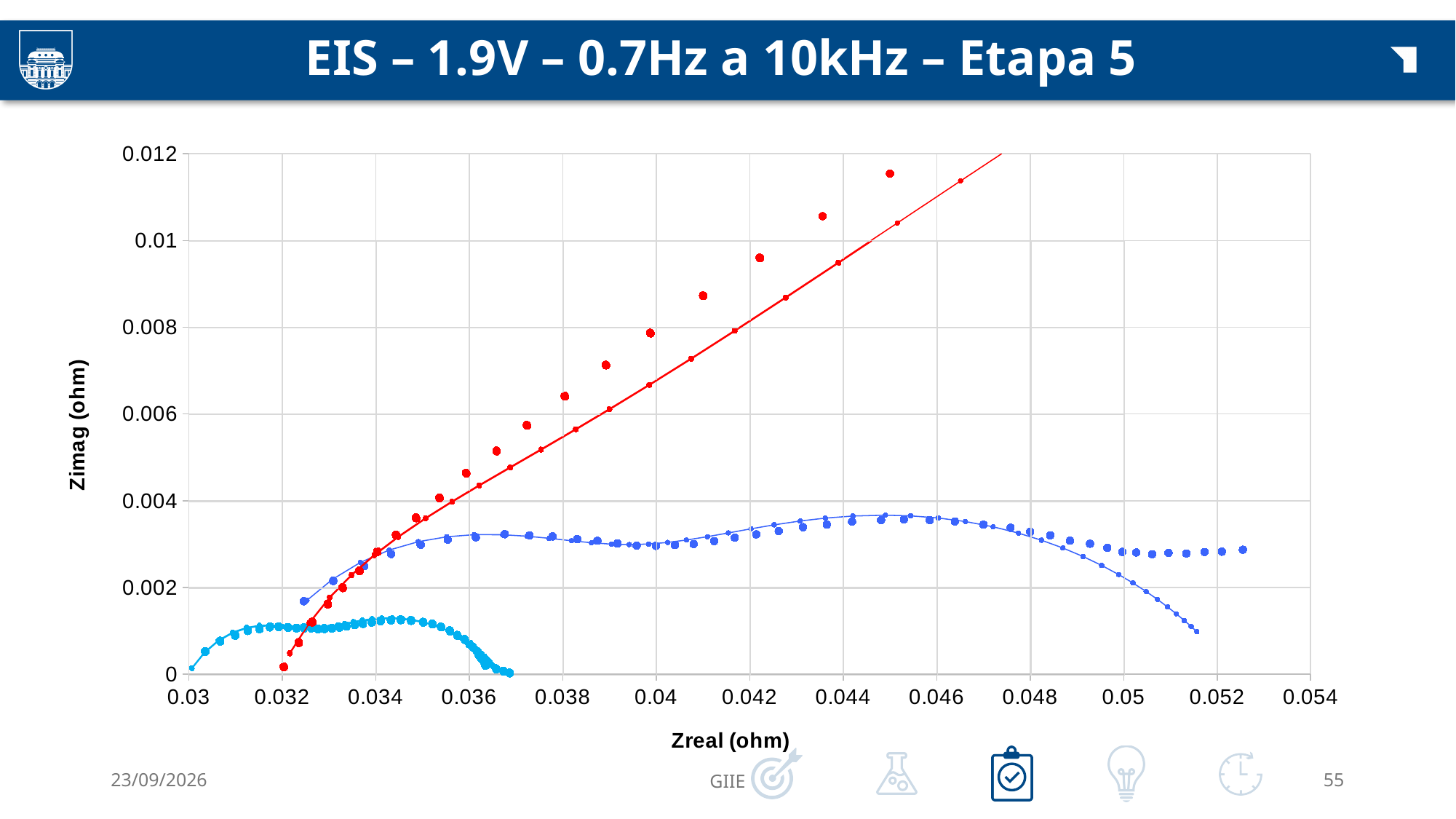
Is the largest Zreal value reached by the light blue (cyan) series greater or less than 0.038? less Which coloured series has the lowest peak Zimag value on the chart? The light blue (cyan) series What is the label of the vertical axis of the chart? Zimag (ohm) What is the title of the chart on the slide? EIS – 1.9V – 0.7Hz a 10kHz – Etapa 5 What kind of chart is shown on the slide? Scatter chart Which coloured series reaches the highest Zimag value on the chart? The red series Does the Zimag value of the red series rise or fall as Zreal increases? Rises Which series reaches a higher Zimag value, the red series or the dark blue series? The red series Does the Zimag value of the light blue (cyan) series rise or fall as Zreal increases from 0.036 to 0.037? Falls Is the highest Zimag value of the red series greater or less than 0.01? greater Is the highest Zimag value of the light blue (cyan) series greater or less than 0.002? less